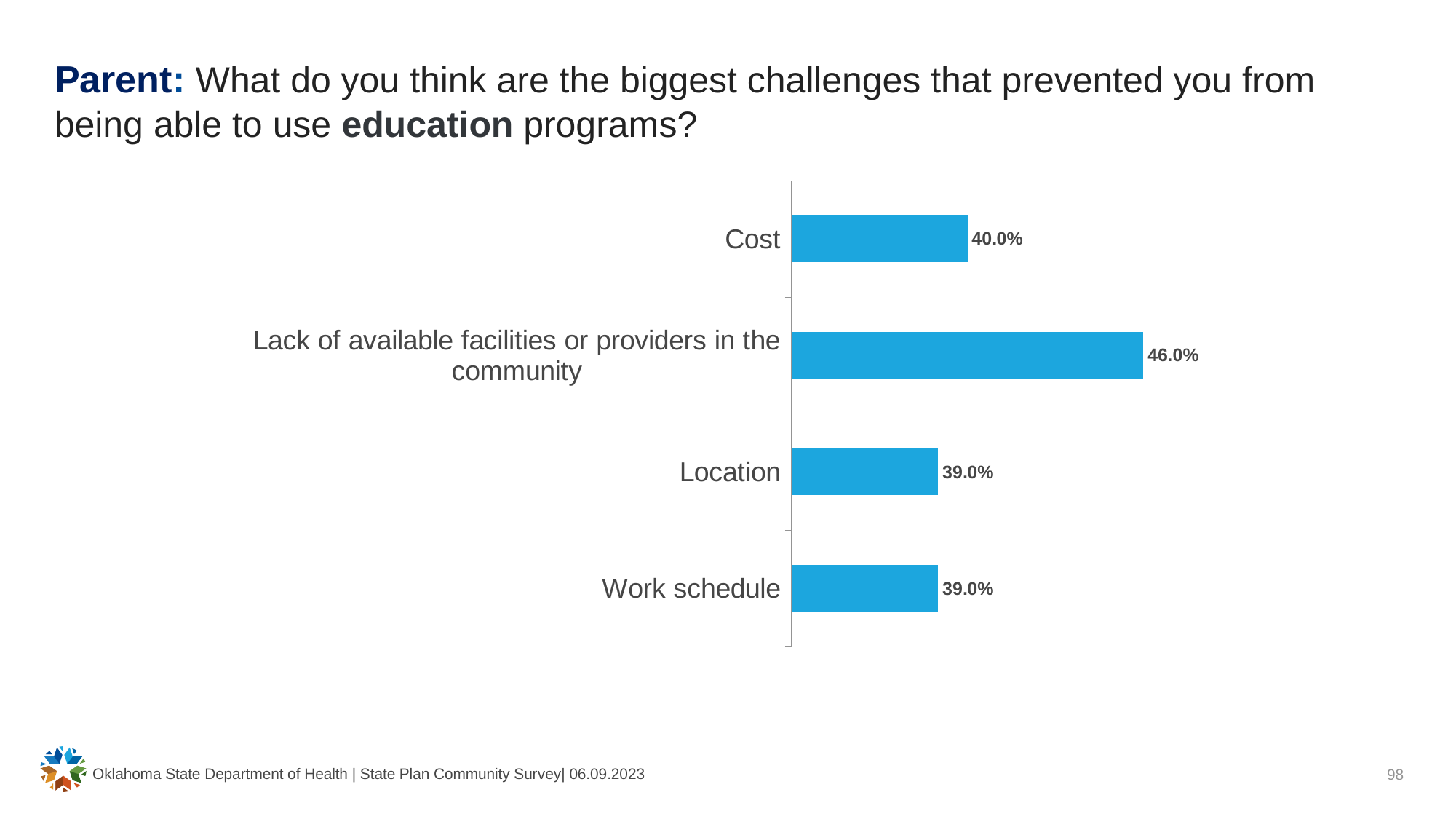
Which challenge has the highest percentage? Lack of available facilities or providers in the community What percentage of parents cited Cost as a challenge to using education programs? 40.0% What percentage is shown for Work schedule? 39.0% What colour are the bars in the chart? Blue What type of chart is shown on the slide? Bar chart What is the difference between the percentage for Lack of available facilities or providers in the community and the percentage for Cost? 6.0% How many challenge categories are shown in the chart? 4 What percentage is shown for Location? 39.0% Which is larger, the value for Cost or the value for Lack of available facilities or providers in the community? Lack of available facilities or providers in the community What is the difference between the percentage for Cost and the percentage for Location? 1.0% Do Location and Work schedule have the same percentage? Yes What is the value shown for Lack of available facilities or providers in the community? 46.0%